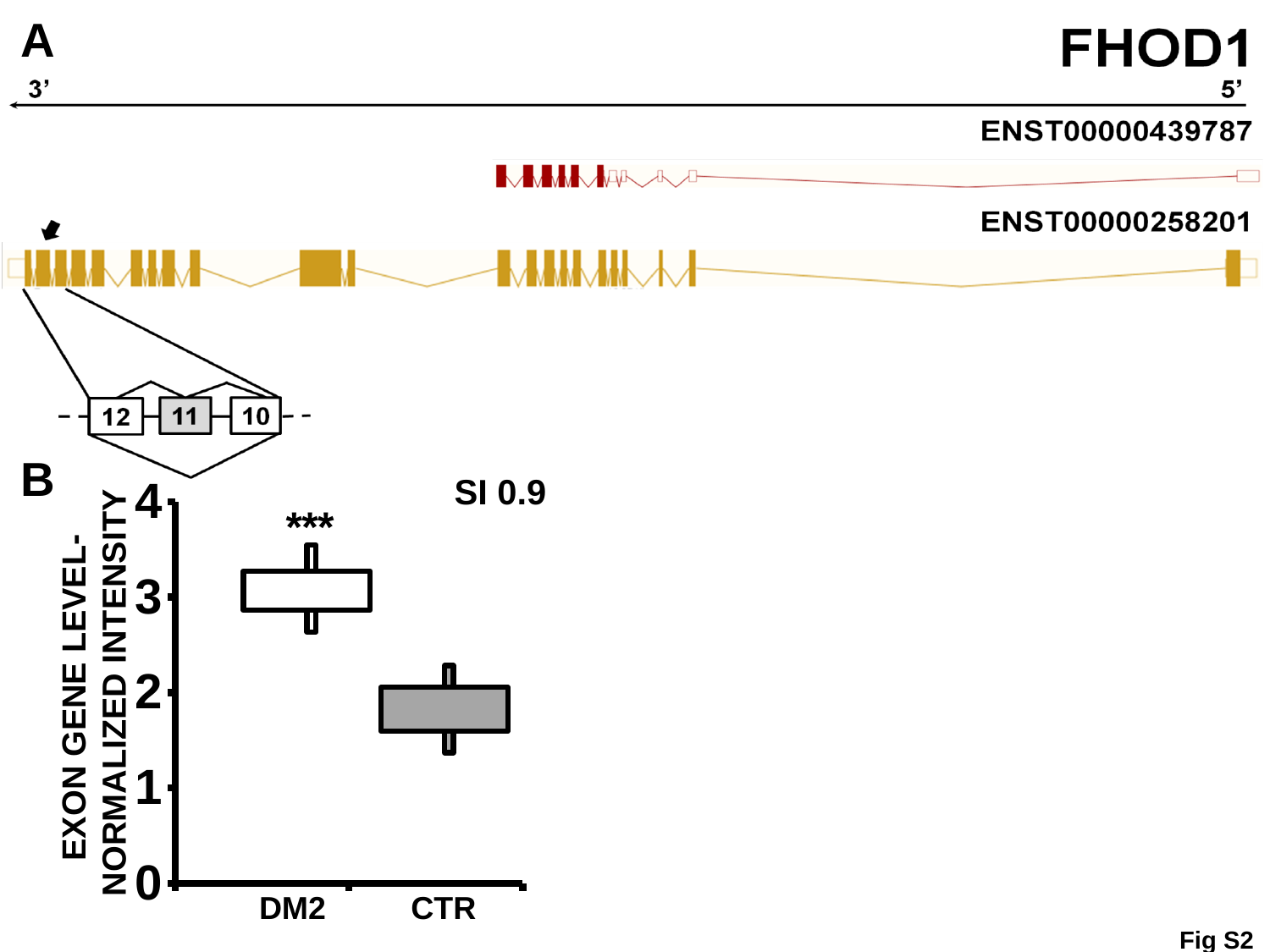
In panel B, is the median value for CTR greater or less than 3? less In panel B, how many groups are plotted on the x axis? 2 In panel B, what is the y-axis label? EXON GENE LEVEL-NORMALIZED INTENSITY In panel B, which group shows the lowest exon gene level-normalized intensity? CTR In panel B, is the median value for CTR greater or less than 1? greater In panel B, is the median value for DM2 greater or less than 2? greater In panel B, what SI value is printed above the chart? SI 0.9 In panel B, which group is marked with three asterisks (***)? DM2 In panel B, what is the maximum value shown on the y axis? 4 In panel B, what kind of chart is shown? box plot In panel B, which group has the higher exon gene level-normalized intensity, DM2 or CTR? DM2